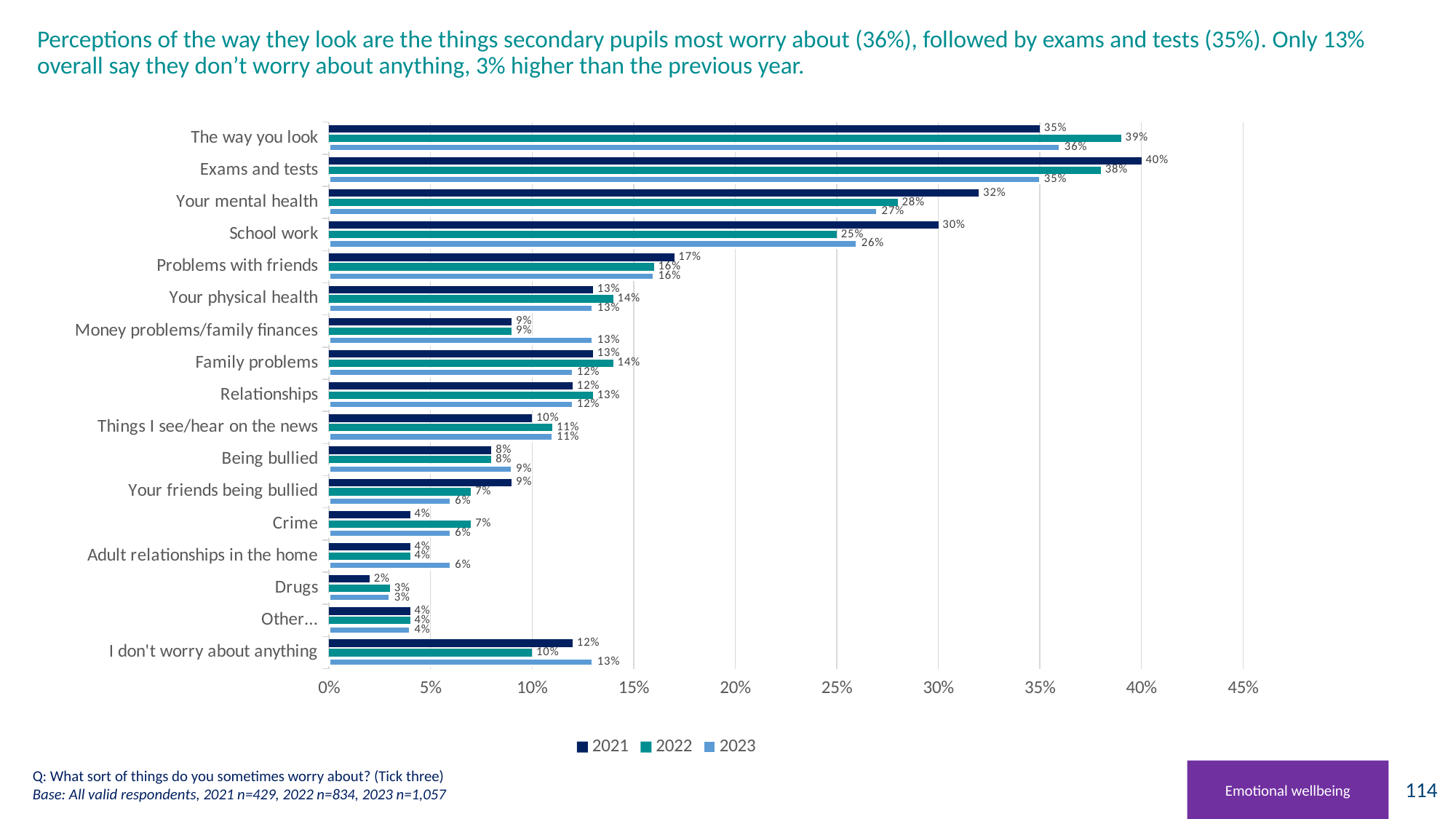
What is the difference between the 2022 and 2023 values for 'Your mental health'? 1% What kind of chart is shown on the slide? Bar chart Which is larger for 'Crime': the 2021 value or the 2022 value? 2022 How many series does the legend list? 3 What is the 2021 value for 'Exams and tests'? 40% What is the 2023 value for 'I don't worry about anything'? 13% What is the 2023 value for 'The way you look'? 36% Which category has the highest 2023 value? The way you look How many categories are shown on the chart? 17 What is the 2022 value for 'School work'? 25% What is the difference between the 2021 and 2023 values for 'Money problems/family finances'? 4% Which category has the lowest 2021 value? Drugs